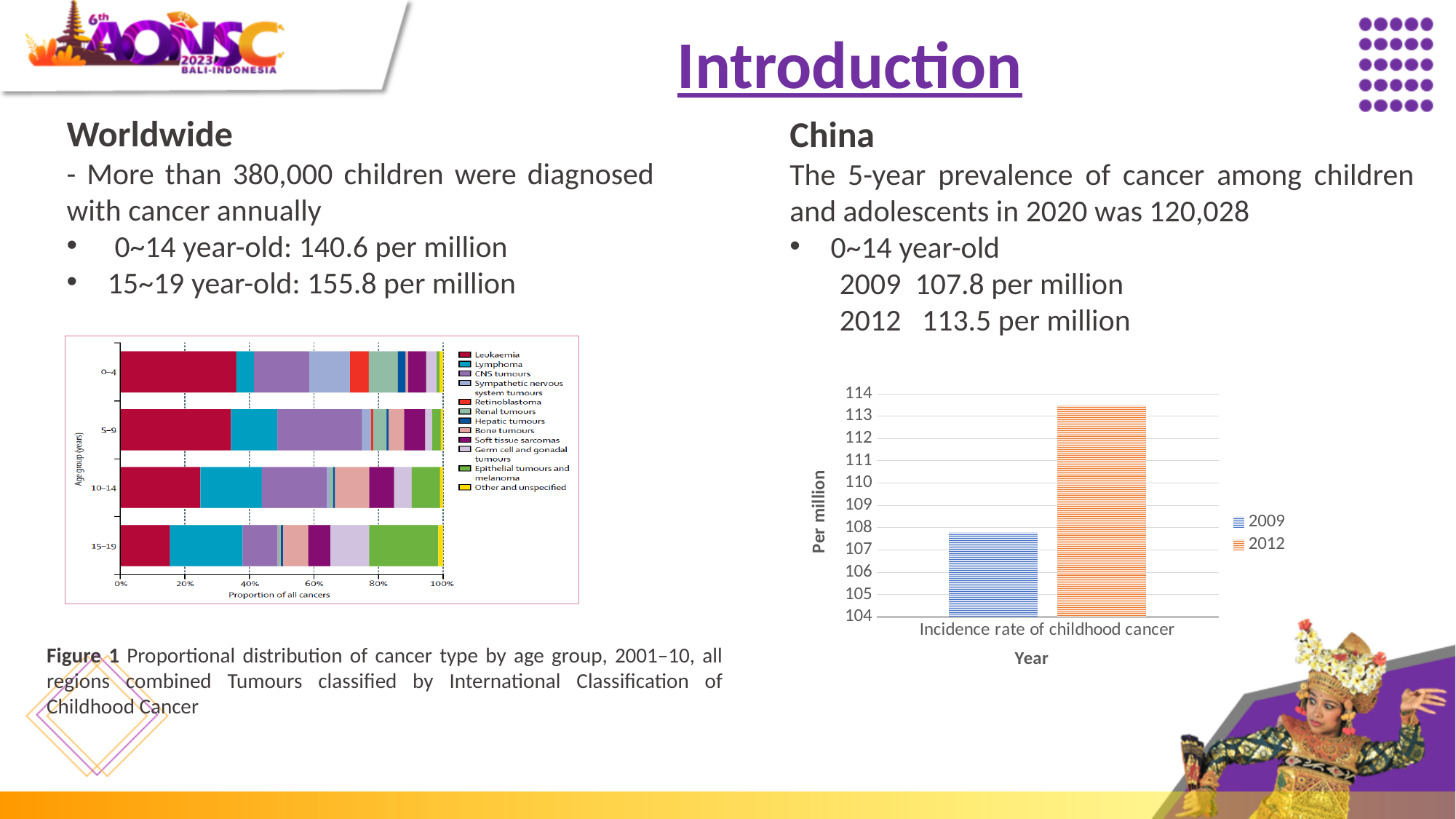
In Figure 1 on the left, which age group has the smallest proportion of leukaemia? 15–19 In the chart on the right (Incidence rate of childhood cancer), is the value for 2009 greater or less than 110? less In the chart on the right (Incidence rate of childhood cancer), how many series does the legend list? 2 In Figure 1 on the left, how many cancer types does the legend list? 12 What is the y-axis label of the chart on the right (Incidence rate of childhood cancer)? Per million In the chart on the right (Incidence rate of childhood cancer), does the incidence rate rise or fall from 2009 to 2012? rise In the chart on the right (Incidence rate of childhood cancer), is the value for 2012 greater or less than 112? greater What kind of chart is the chart on the right of the slide (Incidence rate of childhood cancer)? bar chart In the chart on the right (Incidence rate of childhood cancer), which year has the higher bar, 2009 or 2012? 2012 In Figure 1 on the left, how many age groups are plotted? 4 What kind of chart is Figure 1 on the left of the slide? bar chart In Figure 1 on the left, is the proportion of leukaemia for the 0–4 age group greater or less than 20%? greater